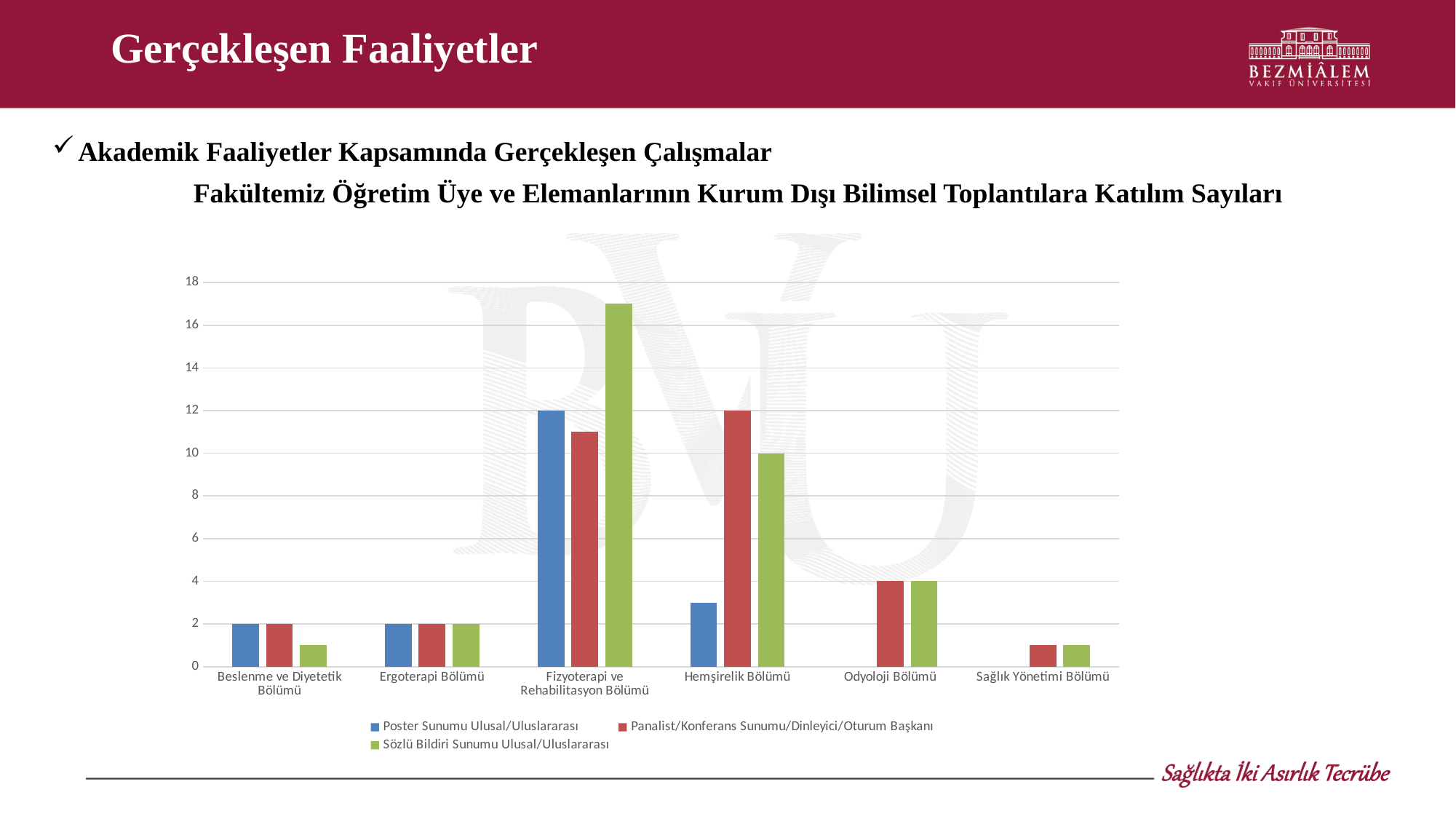
What is the value of Poster Sunumu Ulusal/Uluslararası for Fizyoterapi ve Rehabilitasyon Bölümü? 12 How many series does the chart legend list? 3 Which is larger: the Poster Sunumu Ulusal/Uluslararası value for Fizyoterapi ve Rehabilitasyon Bölümü or for Hemşirelik Bölümü? Fizyoterapi ve Rehabilitasyon Bölümü What is the value of Sözlü Bildiri Sunumu Ulusal/Uluslararası for Odyoloji Bölümü? 4 Is the value of Poster Sunumu Ulusal/Uluslararası for Hemşirelik Bölümü greater or less than 4? less Which department has the highest value for Sözlü Bildiri Sunumu Ulusal/Uluslararası? Fizyoterapi ve Rehabilitasyon Bölümü Is the value of Sözlü Bildiri Sunumu Ulusal/Uluslararası for Fizyoterapi ve Rehabilitasyon Bölümü greater or less than 16? greater For Hemşirelik Bölümü, what is the difference between the Panalist/Konferans Sunumu/Dinleyici/Oturum Başkanı value and the Sözlü Bildiri Sunumu Ulusal/Uluslararası value? 2 How many departments (categories) are shown on the x axis of the chart? 6 What is the value of Panalist/Konferans Sunumu/Dinleyici/Oturum Başkanı for Hemşirelik Bölümü? 12 What is the value of Poster Sunumu Ulusal/Uluslararası for Ergoterapi Bölümü? 2 What kind of chart is shown on the slide? bar chart